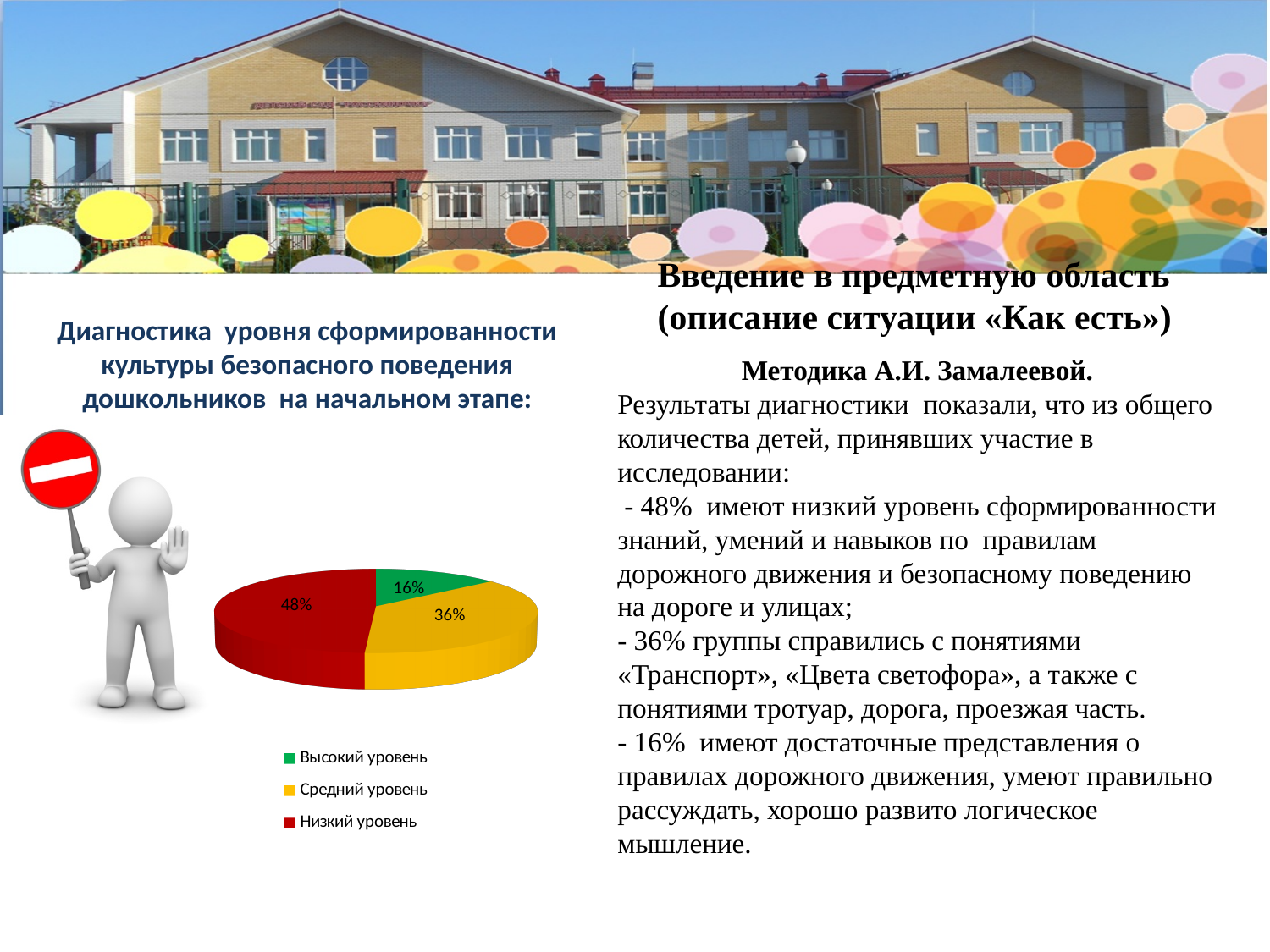
What type of chart is shown on the slide? Pie chart What percentage of the pie chart corresponds to "Низкий уровень"? 48% What is the difference in percentage points between "Средний уровень" and "Высокий уровень"? 20 What percentage of the pie chart corresponds to "Средний уровень"? 36% Which is larger in the pie chart: "Средний уровень" or "Низкий уровень"? Низкий уровень What colour is the slice for "Средний уровень" in the pie chart? Yellow What is the difference in percentage points between "Низкий уровень" and "Высокий уровень"? 32 How many slices does the pie chart have? 3 Which category has the smallest share of the pie chart? Высокий уровень Which category has the largest share of the pie chart? Низкий уровень What percentage of the pie chart corresponds to "Высокий уровень"? 16% How many entries does the chart legend list? 3